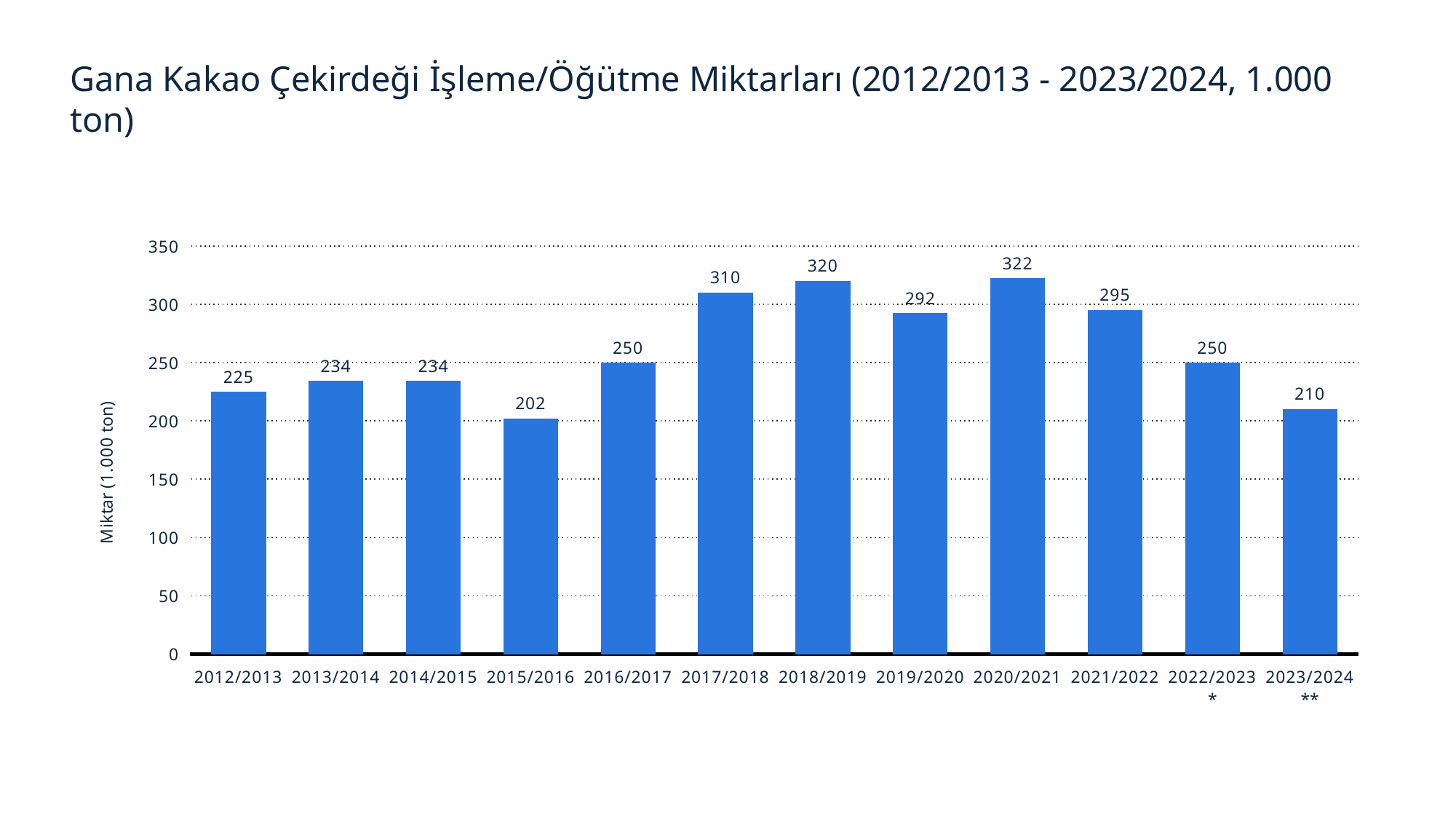
Is the value for 2016/2017 greater or less than 300? less What kind of chart is shown on the slide? bar chart What is the value for 2017/2018? 310 How many seasons are shown on the x axis? 12 Which season has the highest value? 2020/2021 What is the difference between the values for 2018/2019 and 2012/2013? 95 What is the difference between the values for 2020/2021 and 2021/2022? 27 Which season has the lowest value? 2015/2016 What is the value for 2015/2016? 202 What is the value for 2023/2024**? 210 Which is larger, the value for 2019/2020 or the value for 2022/2023*? 2019/2020 What is the label of the y axis? Miktar (1.000 ton)